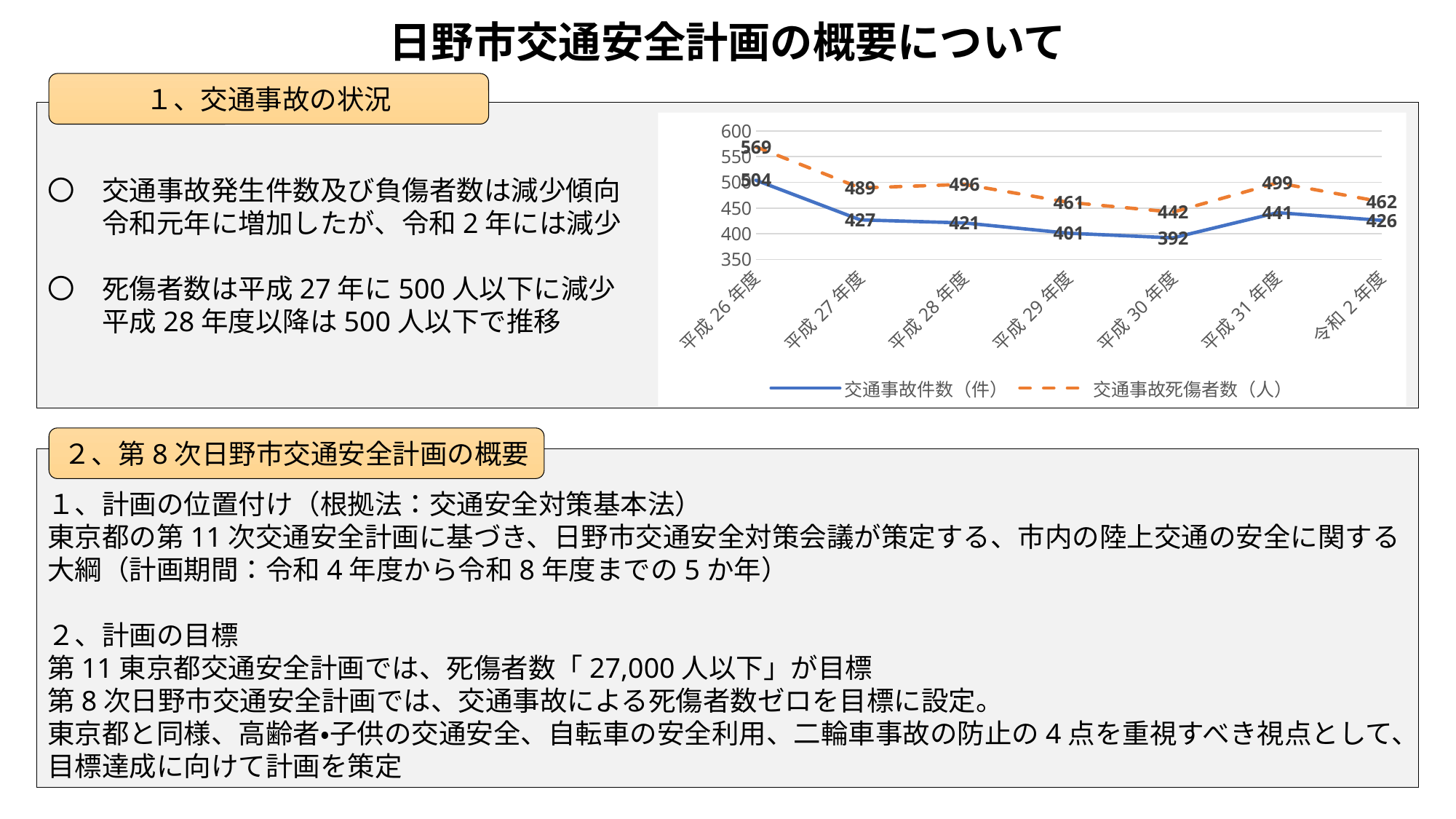
平成30年度の交通事故死傷者数（人）はいくつですか？ 442 令和2年度の交通事故件数（件）はいくつですか？ 426 交通事故件数（件）が最も少ない年度はどれですか？ 平成30年度 凡例で破線で示されている系列はどれですか？ 交通事故死傷者数（人） 横軸にはいくつの年度が示されていますか？ 7 平成28年度と平成29年度では、交通事故死傷者数（人）はどちらが多いですか？ 平成28年度 平成26年度の交通事故件数（件）はいくつですか？ 504 平成31年度の交通事故件数（件）と交通事故死傷者数（人）の差はいくつですか？ 58 凡例にはいくつの系列が示されていますか？ 2 平成26年度と平成27年度の交通事故死傷者数（人）の差はいくつですか？ 80 グラフの種類は何ですか？ 折れ線グラフ 交通事故死傷者数（人）が最も多い年度はどれですか？ 平成26年度